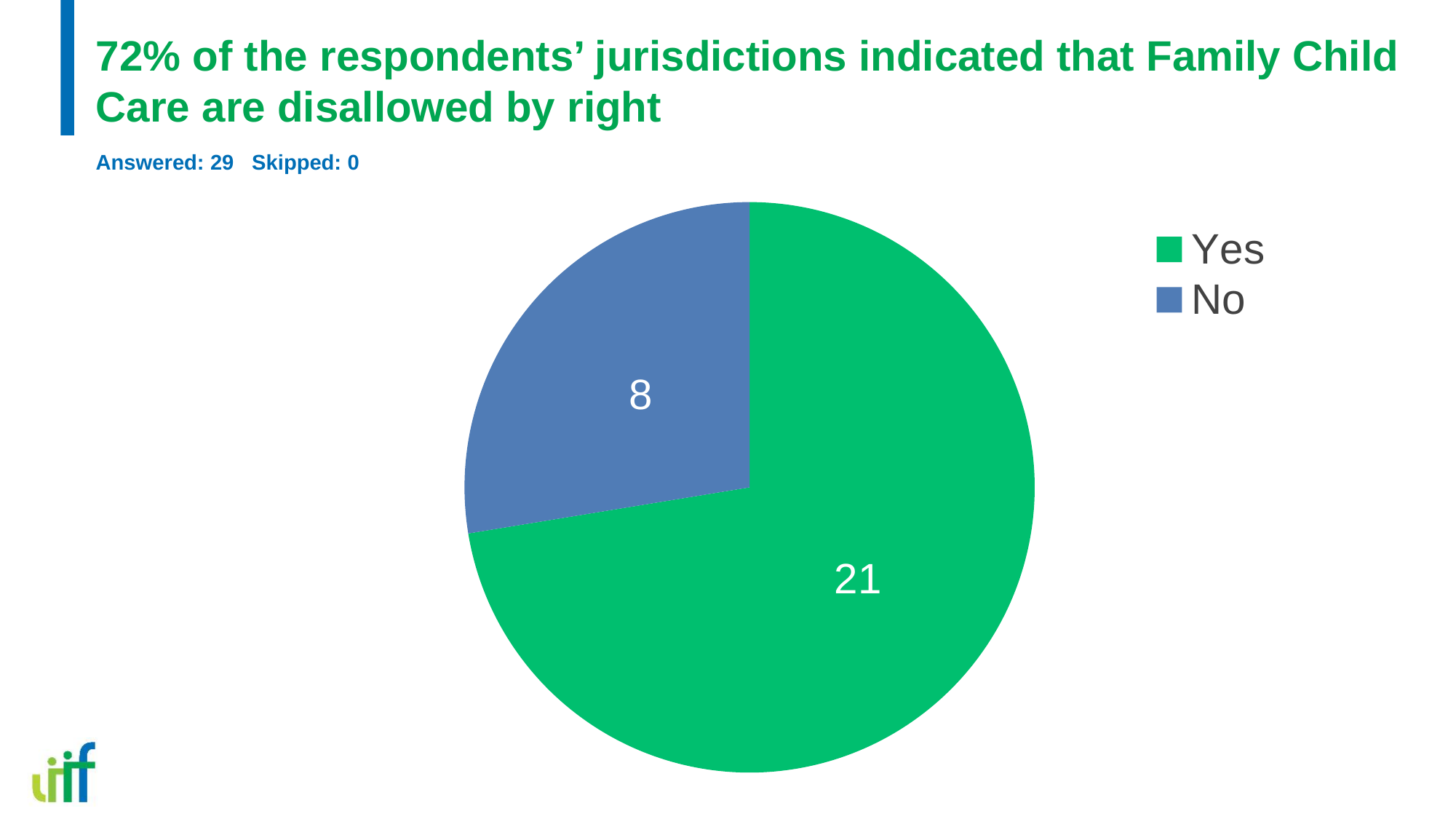
What is the value for the Yes slice? 21 How many entries does the legend list? 2 What is the total of all slices in the pie chart? 29 Which slice is the smallest? No How many slices does the pie chart have? 2 What colour is the Yes slice? green What is the value for the No slice? 8 What type of chart is shown on the slide? pie chart How many respondents answered the question according to the slide? 29 Which slice is the largest? Yes Which is larger, the Yes slice or the No slice? Yes What is the difference between the Yes and No values? 13